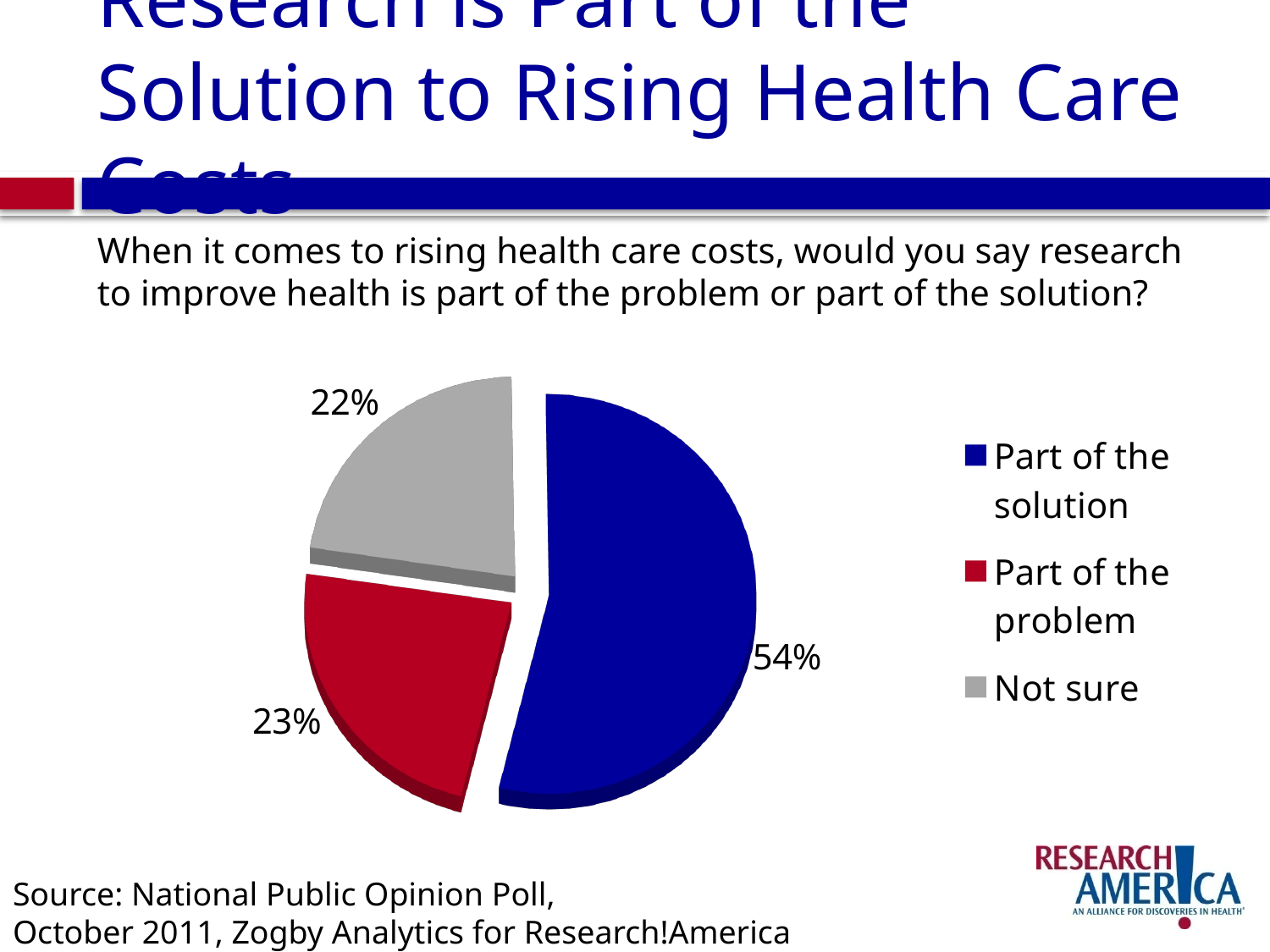
What percentage of respondents said research is part of the solution? 54% What kind of chart is shown on the slide? Pie chart Which response has the smallest share of the pie? Not sure Which response has the largest share of the pie? Part of the solution What colour is the 'Not sure' slice? Gray What percentage of respondents said research is part of the problem? 23% Which is larger, the share for 'Part of the solution' or the share for 'Not sure'? Part of the solution How many entries does the legend list? 3 How many slices does the pie chart have? 3 What colour is the 'Part of the problem' slice? Red What percentage of respondents were not sure? 22% What is the difference in percentage points between 'Part of the solution' and 'Part of the problem'? 31